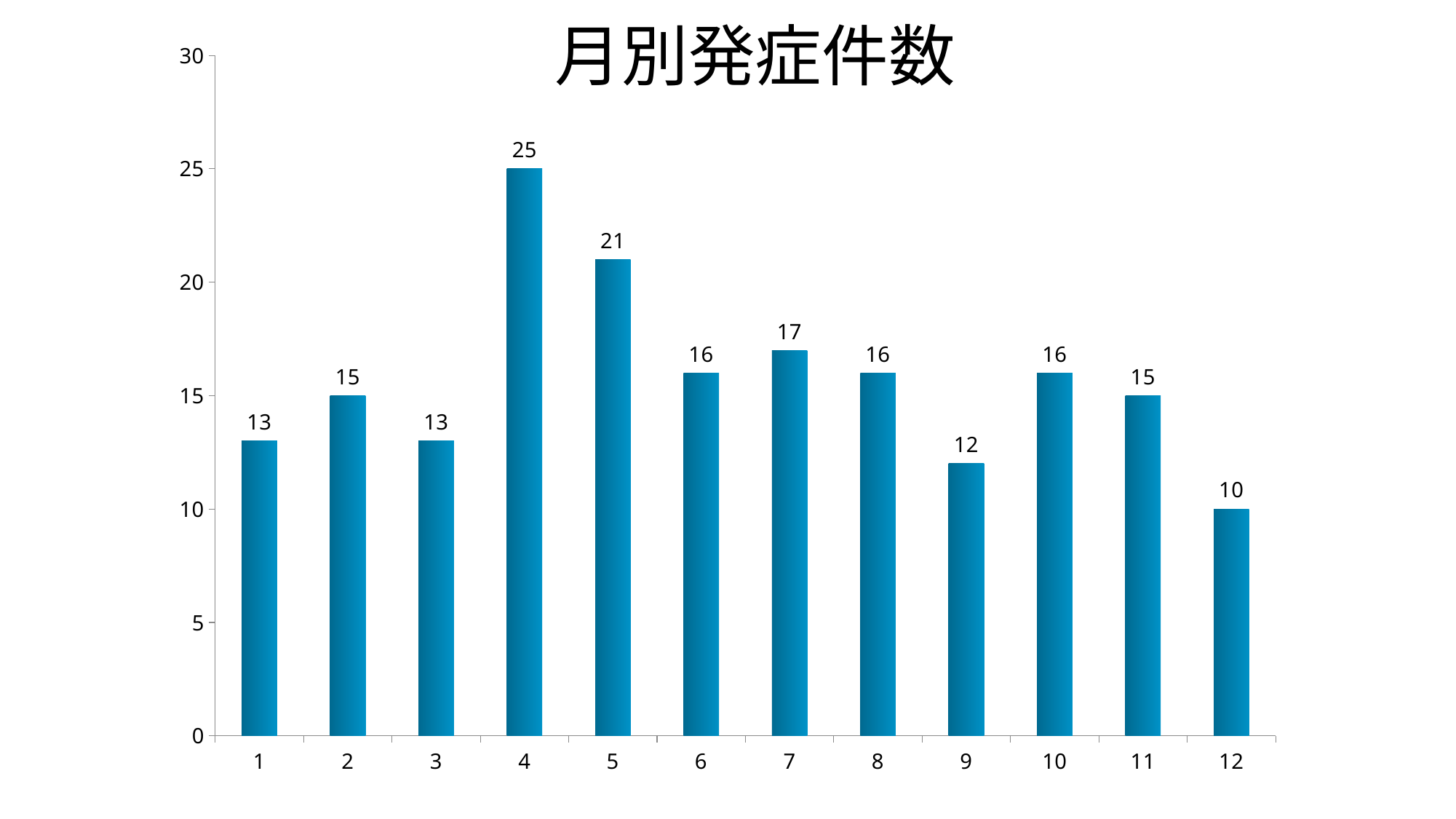
What is the value for month 12? 10 What kind of chart is shown? bar chart Which month has the lowest value? 12 What is the difference between the values for month 4 and month 5? 4 How many months are shown on the x axis? 12 Is the value for month 5 greater or less than 20? greater Which month has the highest value? 4 Which is larger, the value for month 2 or the value for month 9? month 2 What is the value for month 7? 17 What is the title of the chart? 月別発症件数 What is the value for month 4? 25 What is the difference between the values for month 9 and month 12? 2